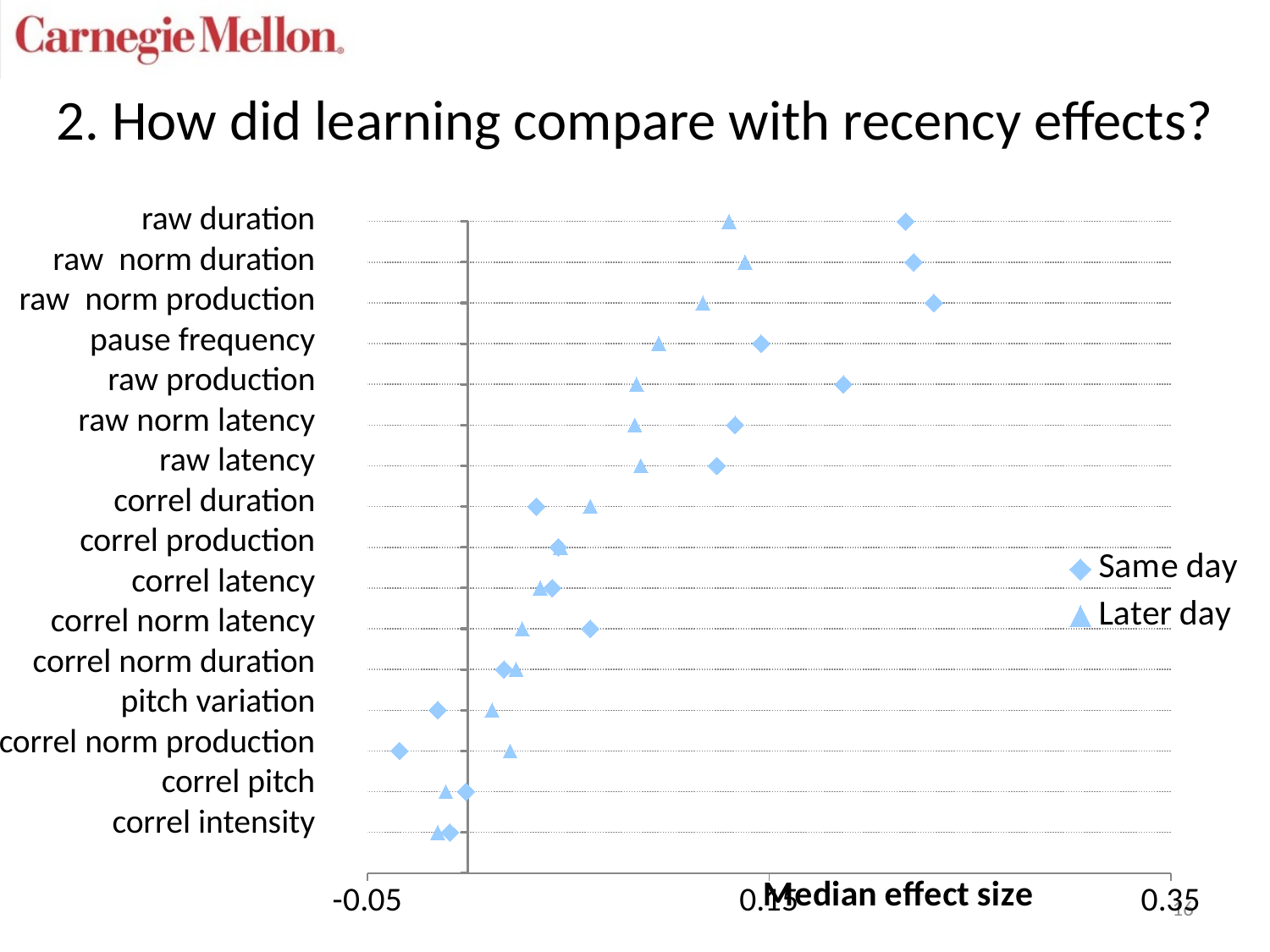
How many categories are plotted on the vertical axis? 16 For raw duration, which series has the larger value, Same day or Later day? Same day What is the title of the horizontal axis? Median effect size Is the Same day value for raw duration greater or less than 0.15? greater How many series does the legend list? 2 What kind of chart is shown on the slide? scatter chart Which series is shown with triangle markers? Later day Which category has the lowest Same day value? correl norm production Is the Same day value for correl norm production greater or less than -0.05? greater Is the Same day value for raw latency greater or less than 0.15? less For correl norm production, which series has the larger value, Same day or Later day? Later day